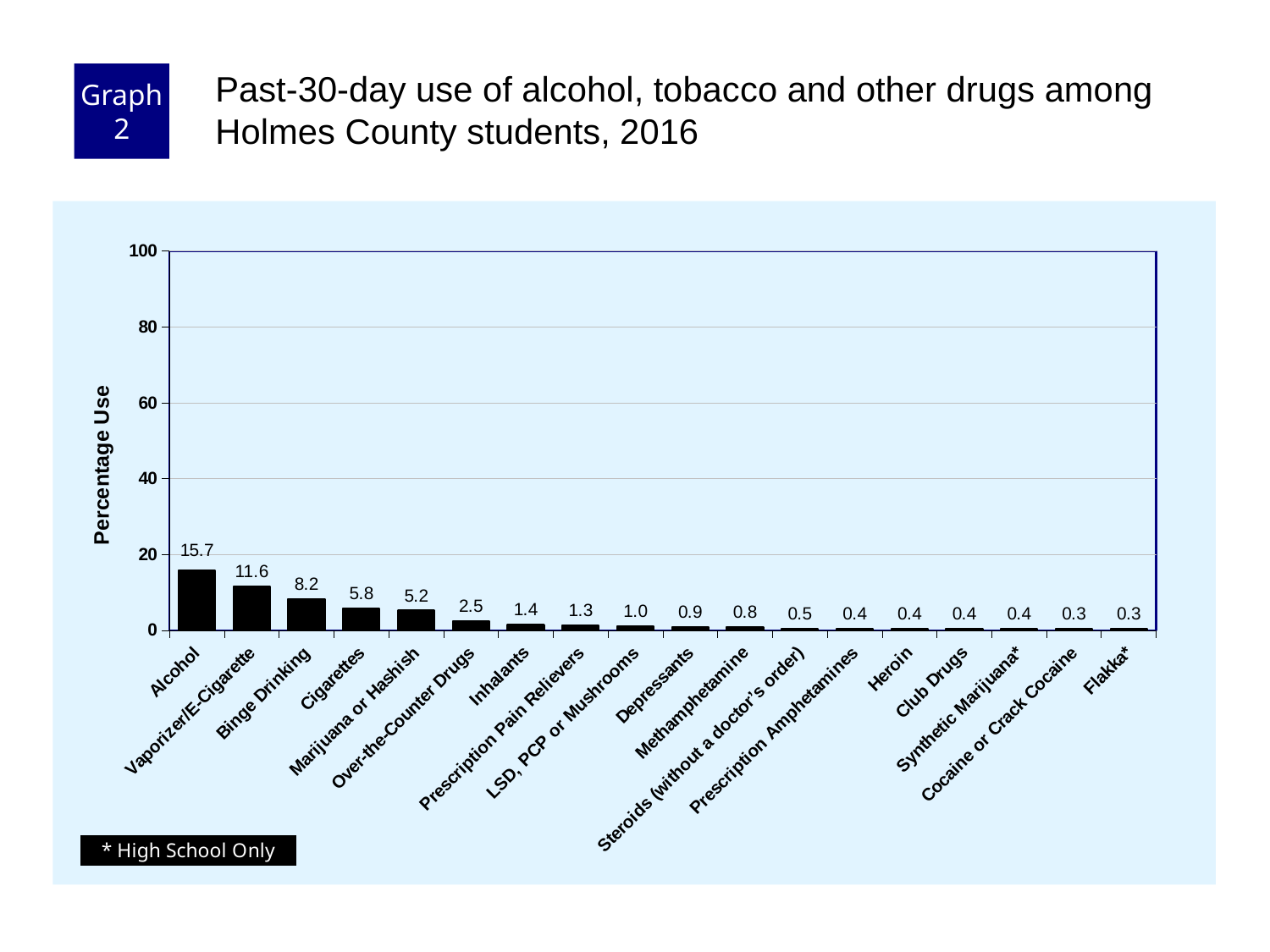
What is the percentage use for Heroin? 0.4 Which category has the highest percentage use? Alcohol What is the difference in percentage use between Binge Drinking and Cigarettes? 2.4 What kind of chart is shown on the slide? Bar chart What is the difference in percentage use between Alcohol and Vaporizer/E-Cigarette? 4.1 What is the percentage use for Alcohol? 15.7 Is the value for Alcohol greater or less than 20? less What is the percentage use for Vaporizer/E-Cigarette? 11.6 How many categories are shown on the x axis? 18 Which has a higher percentage use, Inhalants or Over-the-Counter Drugs? Over-the-Counter Drugs What is the percentage use for Marijuana or Hashish? 5.2 What is the label of the y axis? Percentage Use